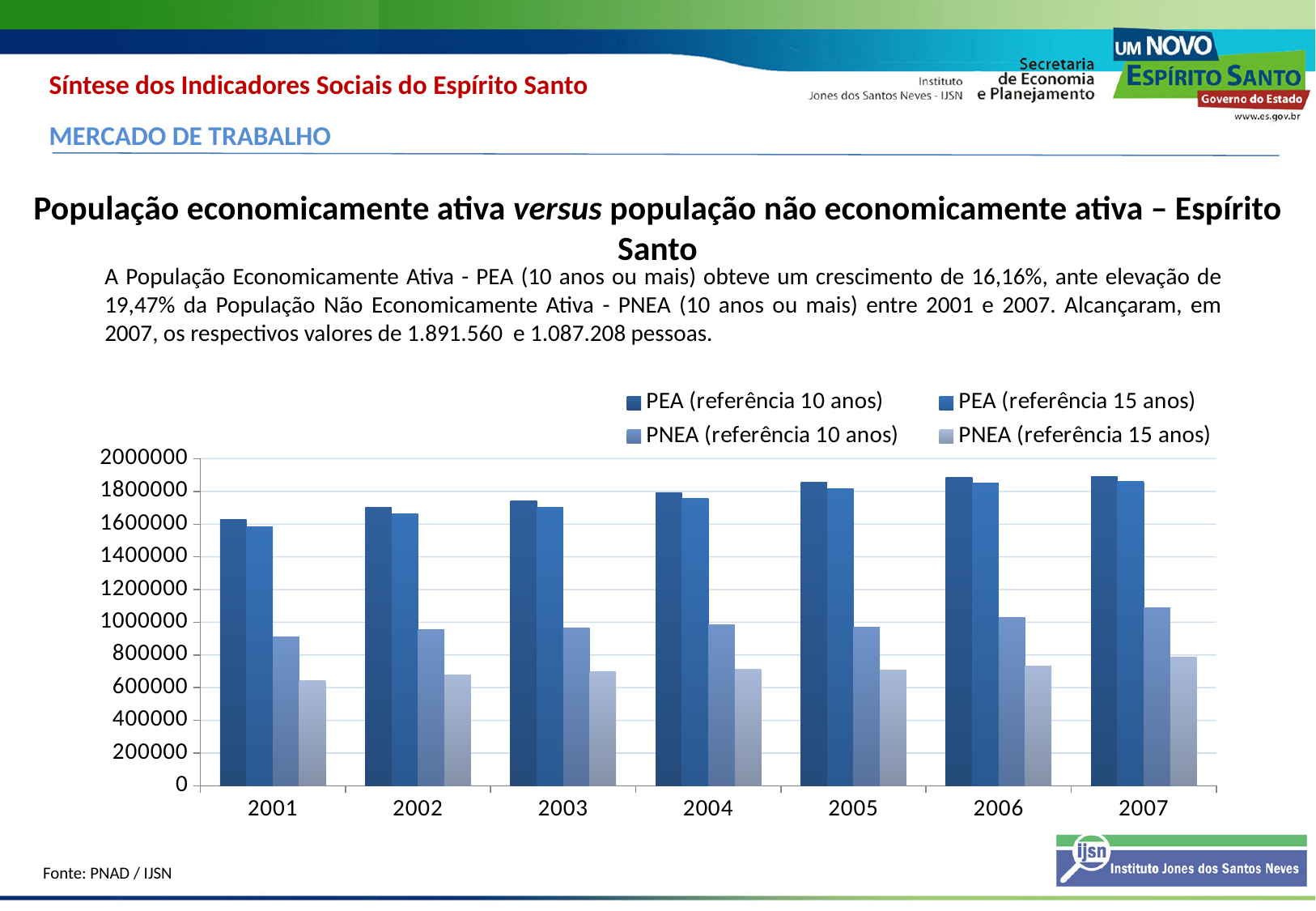
In 2004, which is larger: PEA (referência 10 anos) or PNEA (referência 10 anos)? PEA (referência 10 anos) What kind of chart is shown on the slide? bar chart Does the value for PEA (referência 10 anos) rise or fall from 2001 to 2007? rise Which year has the highest value for PNEA (referência 10 anos)? 2007 Is the value for PNEA (referência 15 anos) in 2001 greater or less than 800000? less How many series does the chart legend list? 4 Is the value for PNEA (referência 10 anos) in 2007 greater or less than 1000000? greater Which year has the lowest value for PEA (referência 10 anos)? 2001 Is the value for PEA (referência 15 anos) in 2007 greater or less than 1600000? greater How many years are shown on the x axis of the chart? 7 What is the source cited below the chart? PNAD / IJSN